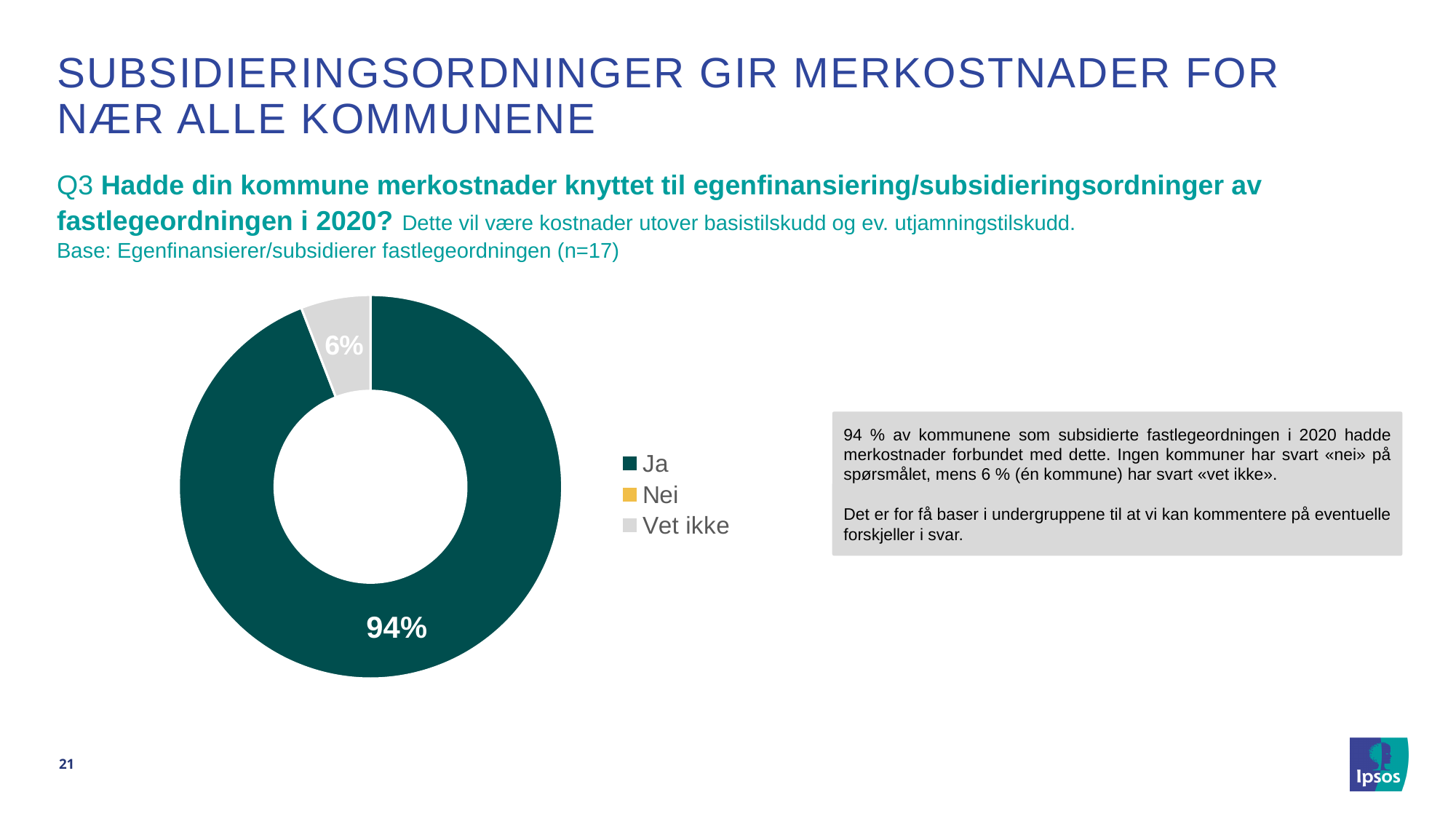
What share of the pie is labelled "Vet ikke"? 6% What is the base size (n) stated for the chart? n=17 Which legend entry has no visible slice in the pie? Nei What is the difference in percentage points between the "Ja" slice and the "Vet ikke" slice? 88 percentage points What kind of chart is shown on the slide? Pie chart (doughnut) What colour is the "Ja" slice of the pie? Dark teal/green What share of the pie is labelled "Ja"? 94% Which category has the largest slice of the pie? Ja Which of the two labelled slices is larger, "Ja" or "Vet ikke"? Ja How many entries does the legend list? 3